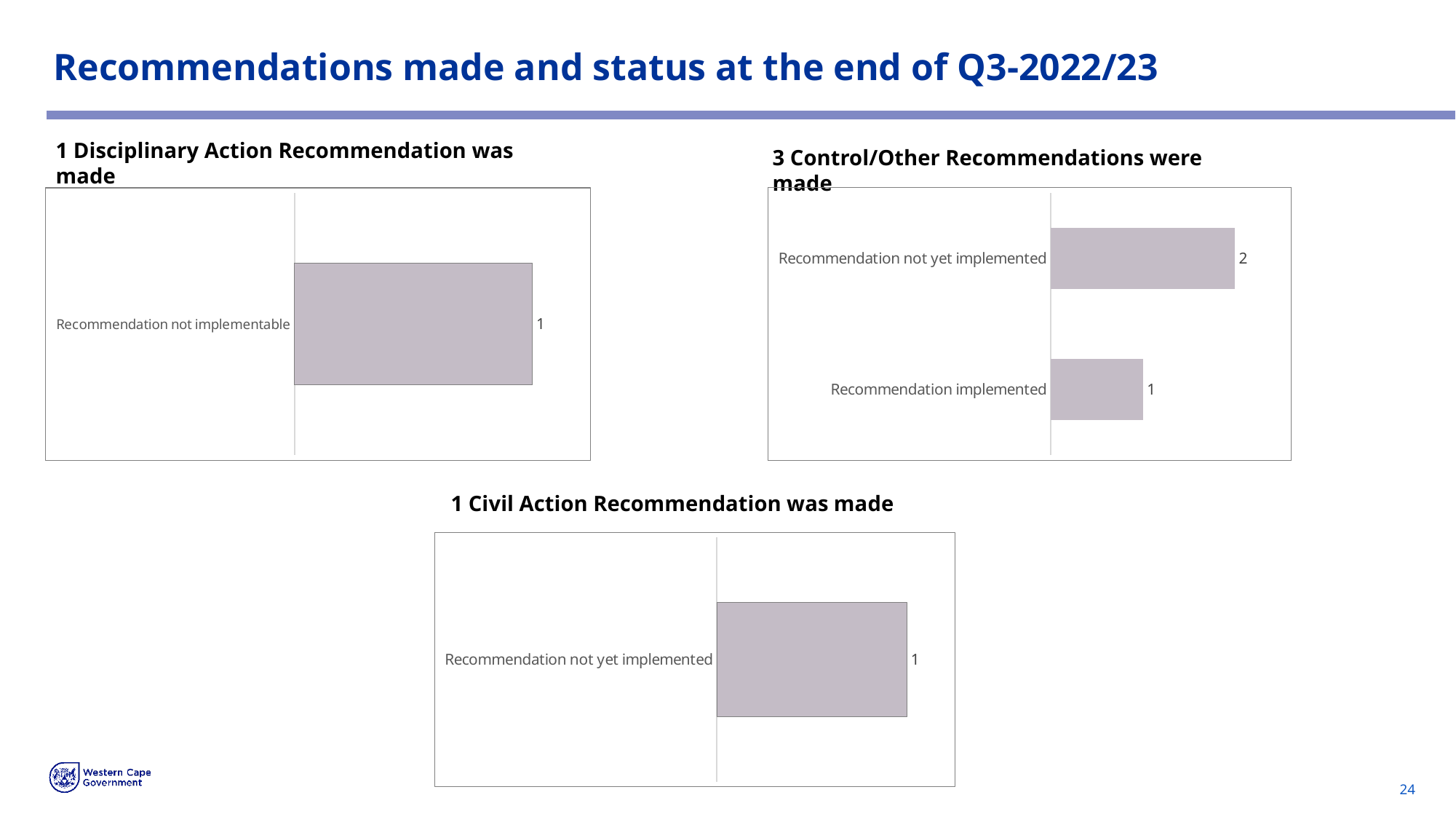
In the '3 Control/Other Recommendations were made' chart, which category has the lowest value? Recommendation implemented How many categories are shown in the '3 Control/Other Recommendations were made' chart? 2 In the '3 Control/Other Recommendations were made' chart, which is larger: 'Recommendation not yet implemented' or 'Recommendation implemented'? Recommendation not yet implemented How many charts are shown on the slide? 3 In the '3 Control/Other Recommendations were made' chart, which category has the highest value? Recommendation not yet implemented In the '3 Control/Other Recommendations were made' chart, what is the value for 'Recommendation not yet implemented'? 2 In the '1 Disciplinary Action Recommendation was made' chart, what is the value for 'Recommendation not implementable'? 1 In the '3 Control/Other Recommendations were made' chart, what is the difference between 'Recommendation not yet implemented' and 'Recommendation implemented'? 1 How many categories are shown in the '1 Disciplinary Action Recommendation was made' chart? 1 In the '3 Control/Other Recommendations were made' chart, what is the value for 'Recommendation implemented'? 1 What type of chart is the '1 Civil Action Recommendation was made' chart? Bar chart In the '1 Civil Action Recommendation was made' chart, what is the value for 'Recommendation not yet implemented'? 1